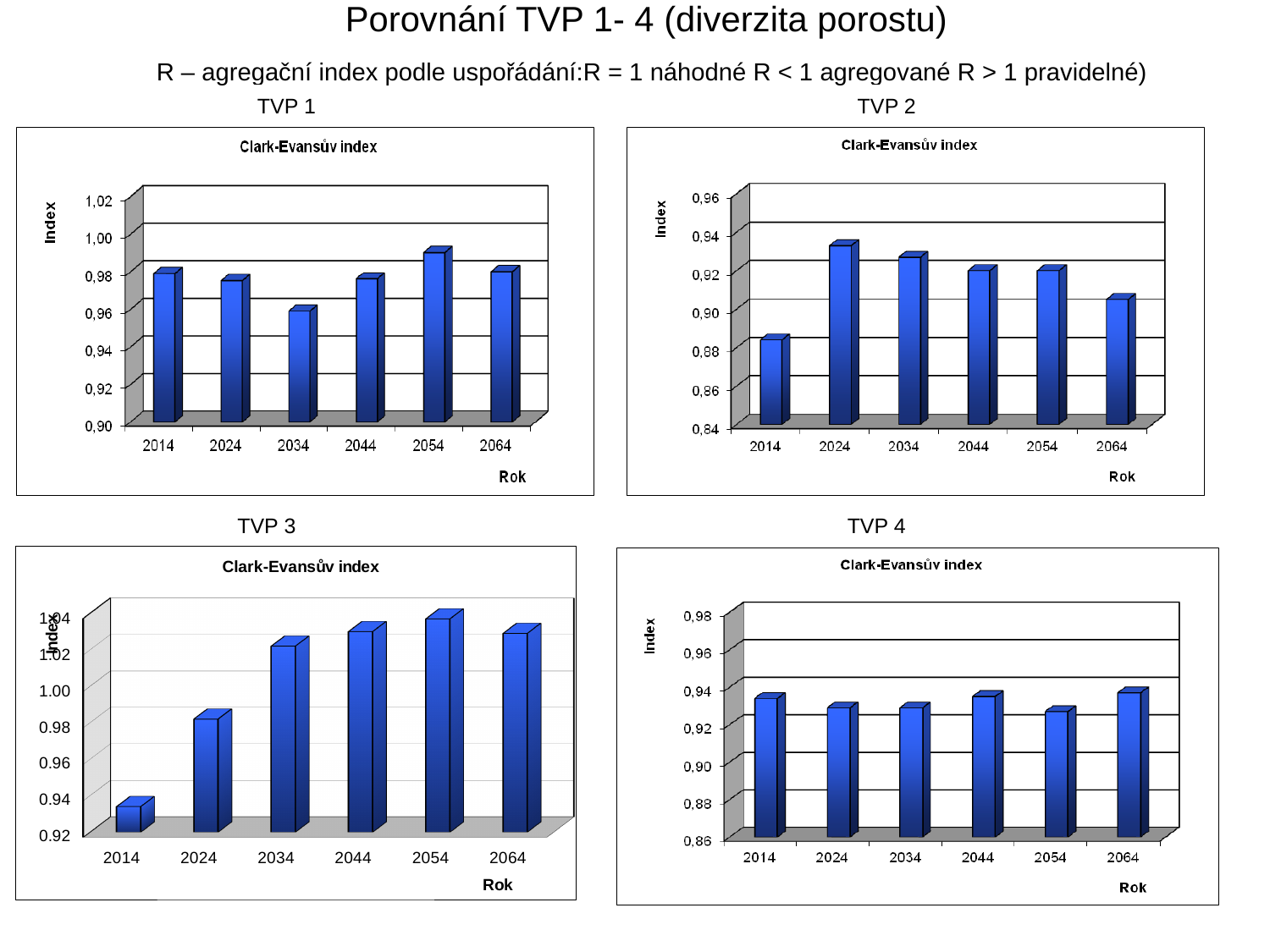
In the TVP 1 chart, which year has the lowest Clark-Evansův index? 2034 In the TVP 4 chart, is the value for 2054 greater or less than 0,94? less In the TVP 2 chart, which year has the lowest Clark-Evansův index? 2014 In the TVP 3 chart, which year has the lowest Clark-Evansův index? 2014 In the TVP 3 chart, do the values rise or fall from 2014 to 2054? rise How many years are shown on the x axis of the TVP 4 chart? 6 In the TVP 3 chart, is the value for 2054 greater or less than 1.02? greater In the TVP 1 chart, which year has the highest Clark-Evansův index? 2054 In the TVP 2 chart, is the value for 2014 greater or less than 0,90? less In the TVP 2 chart, which year has the highest Clark-Evansův index? 2024 What type of chart is the TVP 1 chart? bar chart